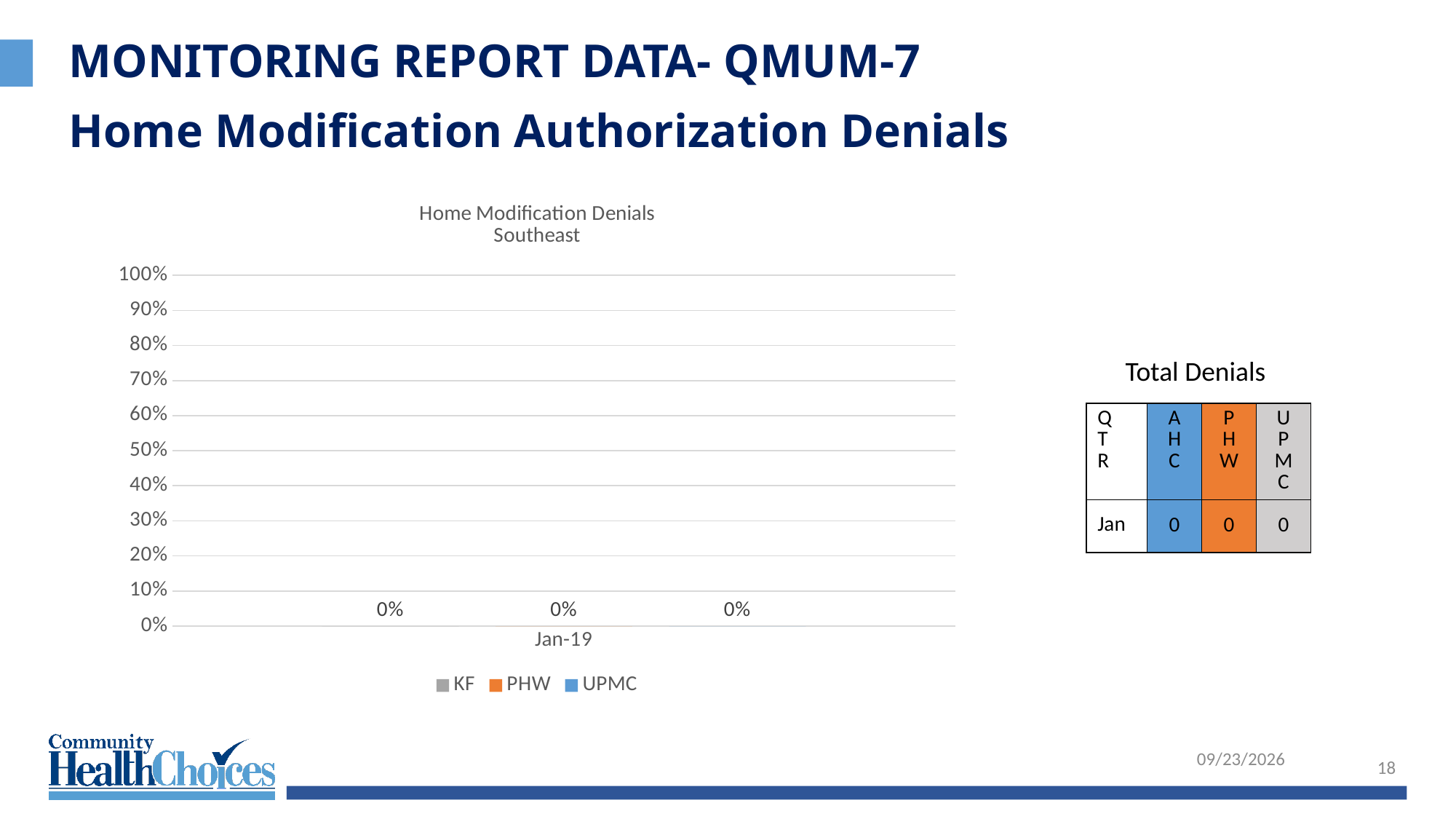
How many series does the legend list? 3 What is the value for UPMC in Jan-19? 0% Which series are listed in the legend? KF, PHW, UPMC How many categories are shown on the x axis? 1 What kind of chart is shown? bar chart What is the value for PHW in Jan-19? 0% What is the difference between the values for KF and PHW in Jan-19? 0% What is the highest value shown on the y axis? 100% What category label appears on the x axis? Jan-19 Is the value for UPMC in Jan-19 greater or less than 50%? less What is the value for KF in Jan-19? 0% What is the title of the chart? Home Modification Denials Southeast